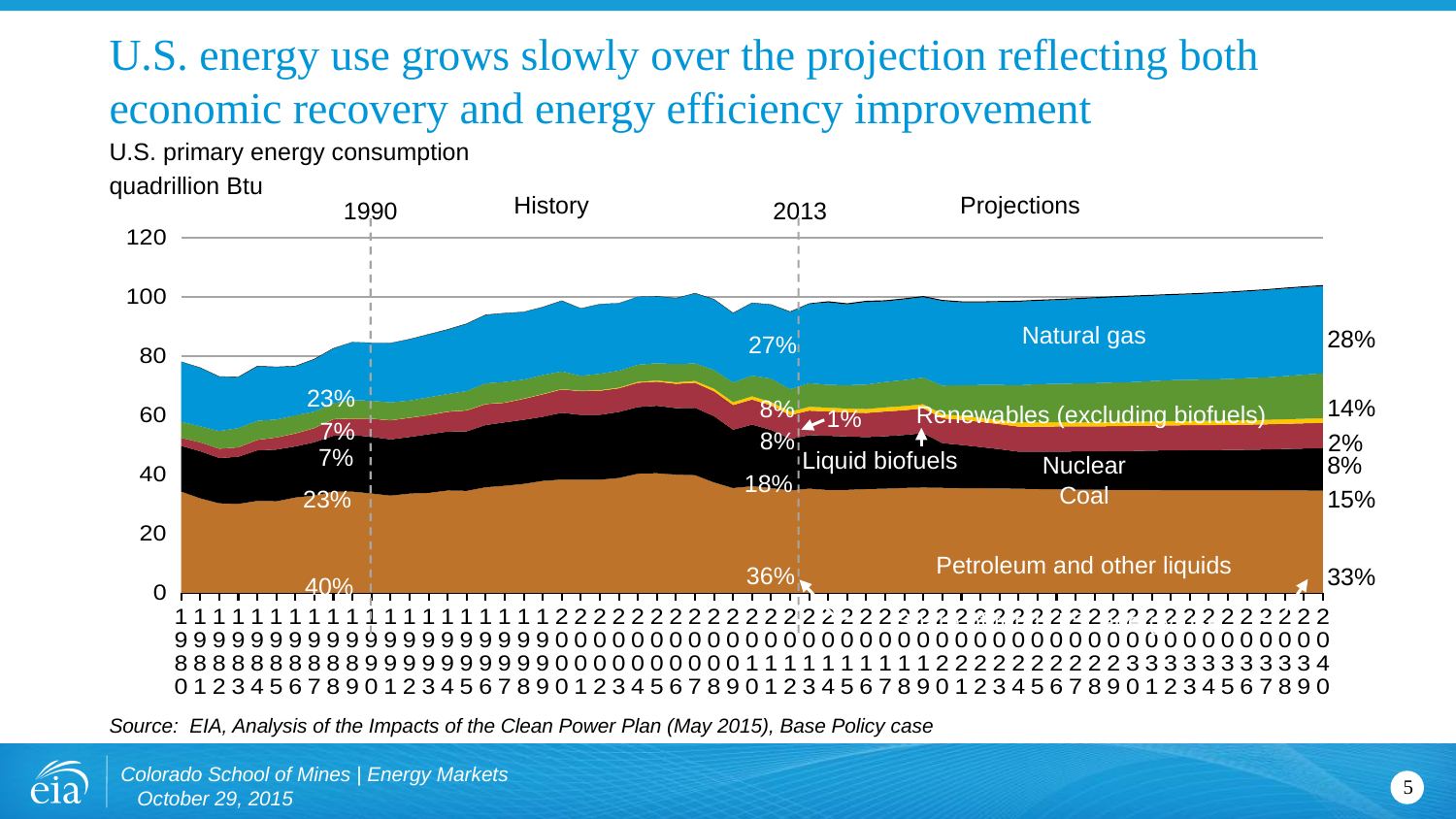
What share of U.S. primary energy consumption do renewables (excluding biofuels) account for in 2040? 14% What share of U.S. primary energy consumption does natural gas account for in 2040 according to the chart? 28% Which fuel has the largest share of U.S. primary energy consumption in 2040? Petroleum and other liquids Is total U.S. primary energy consumption in 2040 greater or less than 100 quadrillion Btu? greater In 2013, which had the larger share: natural gas or coal? Natural gas Which fuel has the smallest share of U.S. primary energy consumption in 2040? Liquid biofuels What type of chart is shown on the slide? Stacked area chart What share of U.S. primary energy consumption did coal account for in 2013? 18% How many fuel categories are labeled in the chart? 6 What share of U.S. primary energy consumption did petroleum and other liquids account for in 1990? 40% What share of U.S. primary energy consumption did liquid biofuels account for in 2013? 1% By how many percentage points does the coal share fall between 1990 and 2040? 8 percentage points